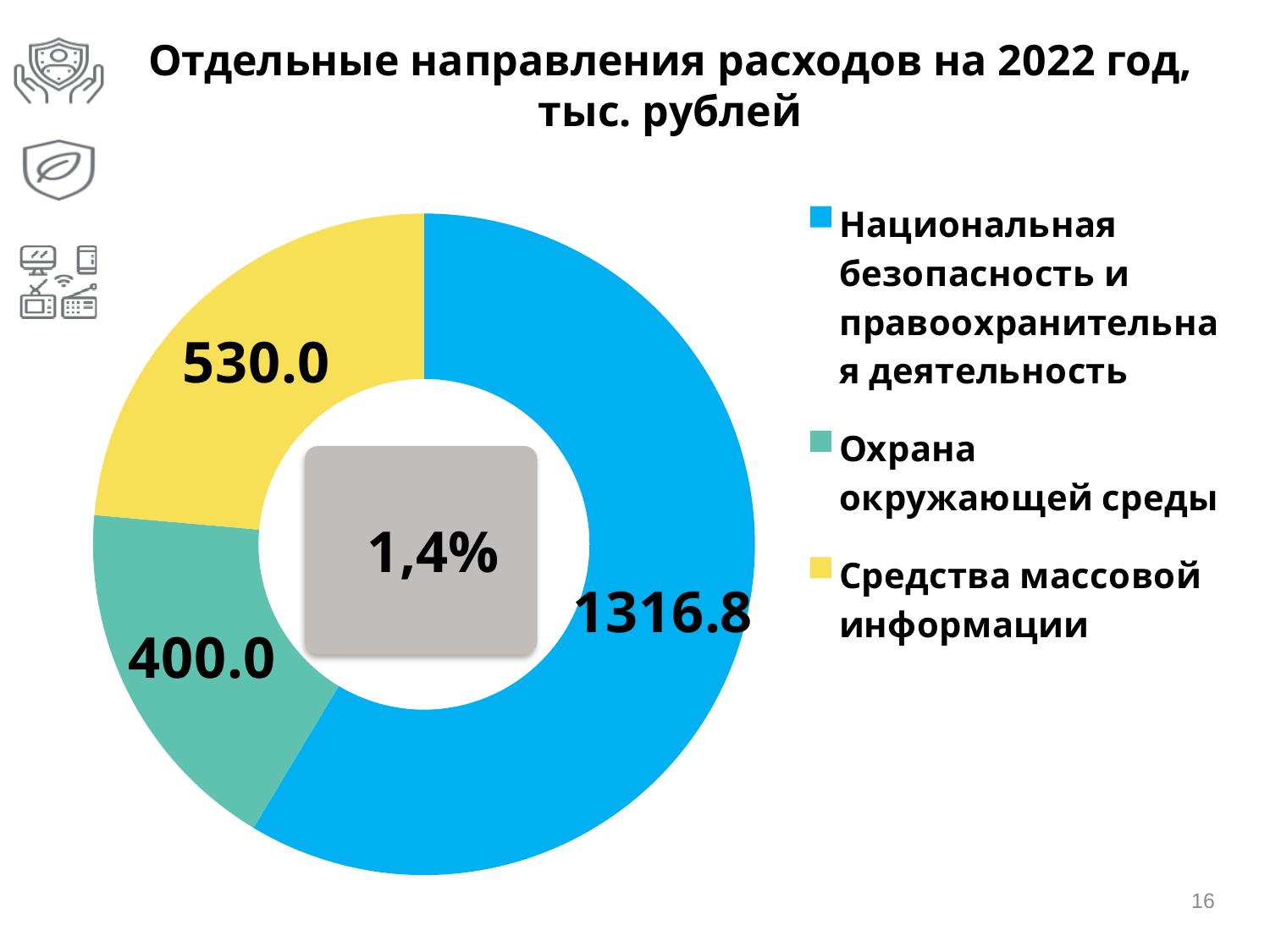
What kind of chart is shown on the slide? doughnut chart What is the value for Национальная безопасность и правоохранительная деятельность? 1316.8 Which is larger: the value for Средства массовой информации or the value for Охрана окружающей среды? Средства массовой информации What is the value for Охрана окружающей среды? 400.0 Which category has the largest value? Национальная безопасность и правоохранительная деятельность What is the difference between the values for Средства массовой информации and Охрана окружающей среды? 130.0 Which category has the smallest value? Охрана окружающей среды What is the value for Средства массовой информации? 530.0 What is the difference between the values for Национальная безопасность и правоохранительная деятельность and Средства массовой информации? 786.8 What percentage is shown in the centre of the chart? 1,4% How many categories does the chart show? 3 What is the total of all three values shown on the chart? 2246.8